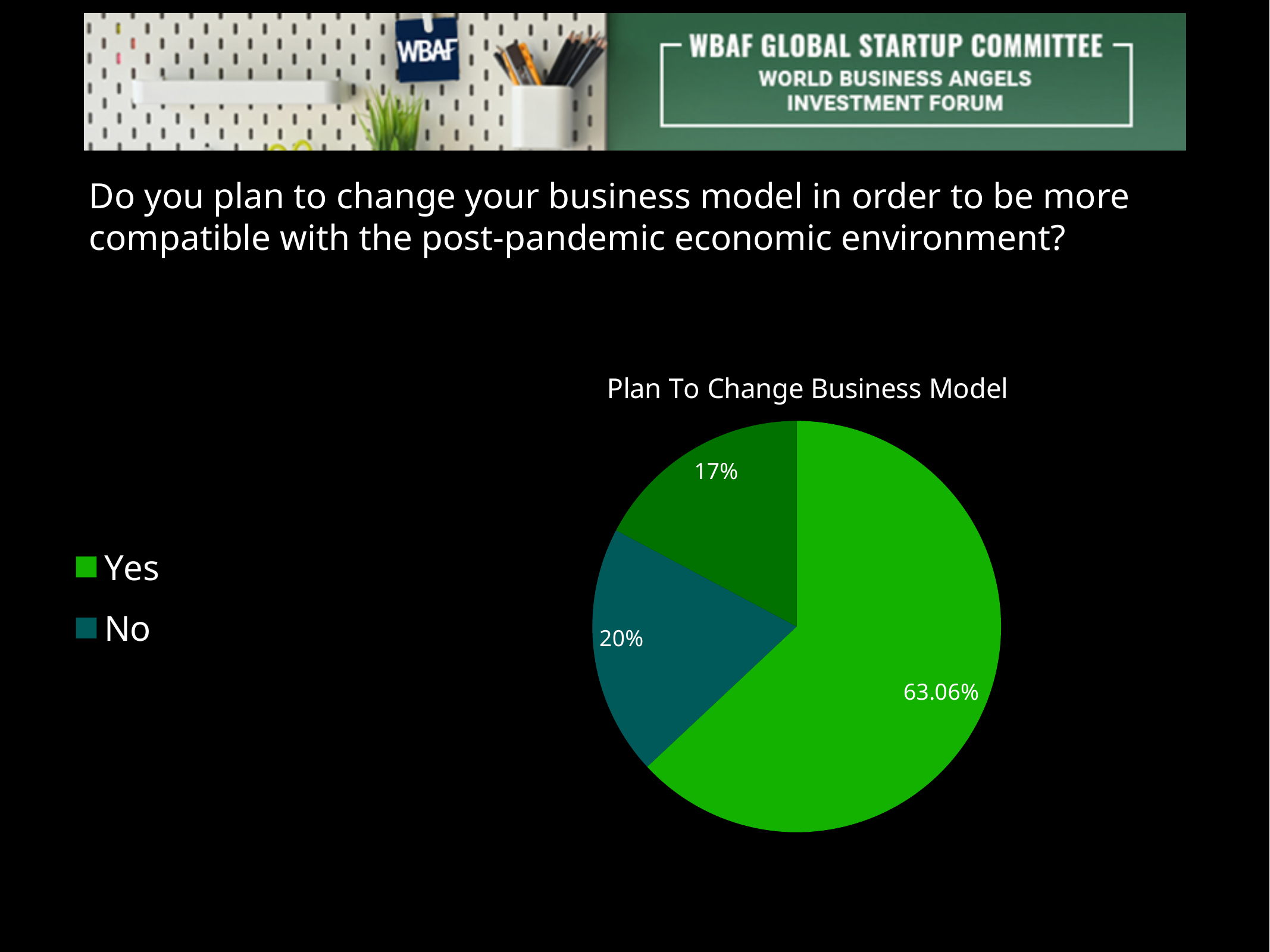
By how many percentage points does the Yes slice exceed the No slice? 43.06% What kind of chart is shown on the slide? Pie chart What colour is the Yes slice in the pie chart? Bright green Which legend category has the largest slice of the pie? Yes What is the title of the pie chart? Plan To Change Business Model What percentage of the pie chart is the No slice? 20% What percentage of the pie chart is the Yes slice? 63.06% Which slice is larger, Yes or No? Yes How many entries does the legend list? 2 How many slices does the pie chart have? 3 What is the smallest percentage label shown on the pie chart? 17%